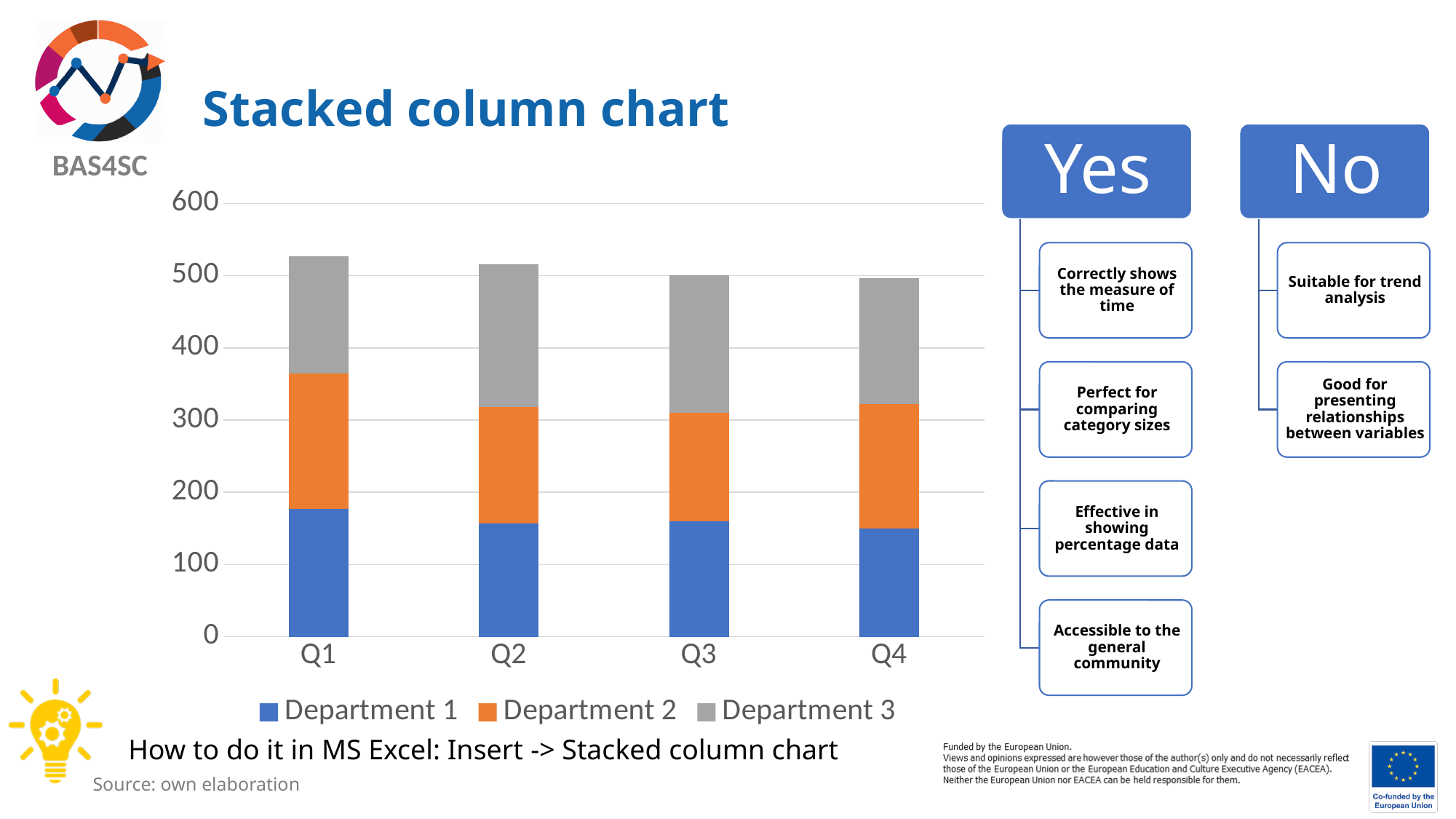
Do the total bar heights rise or fall from Q1 to Q4? fall Which quarter has the tallest stacked bar? Q1 Which is larger, the total stacked bar for Q1 or for Q4? Q1 How many series does the chart legend list? 3 How many categories are shown on the x axis of the chart? 4 Is the total of the Q4 bar greater or less than 600? less What kind of chart is shown on the slide? Stacked bar chart Is the Department 1 value for Q2 greater or less than 100? greater Which colour represents Department 3 in the chart? Grey Which quarter has the shortest stacked bar? Q4 Is the total of the Q1 bar greater or less than 500? greater